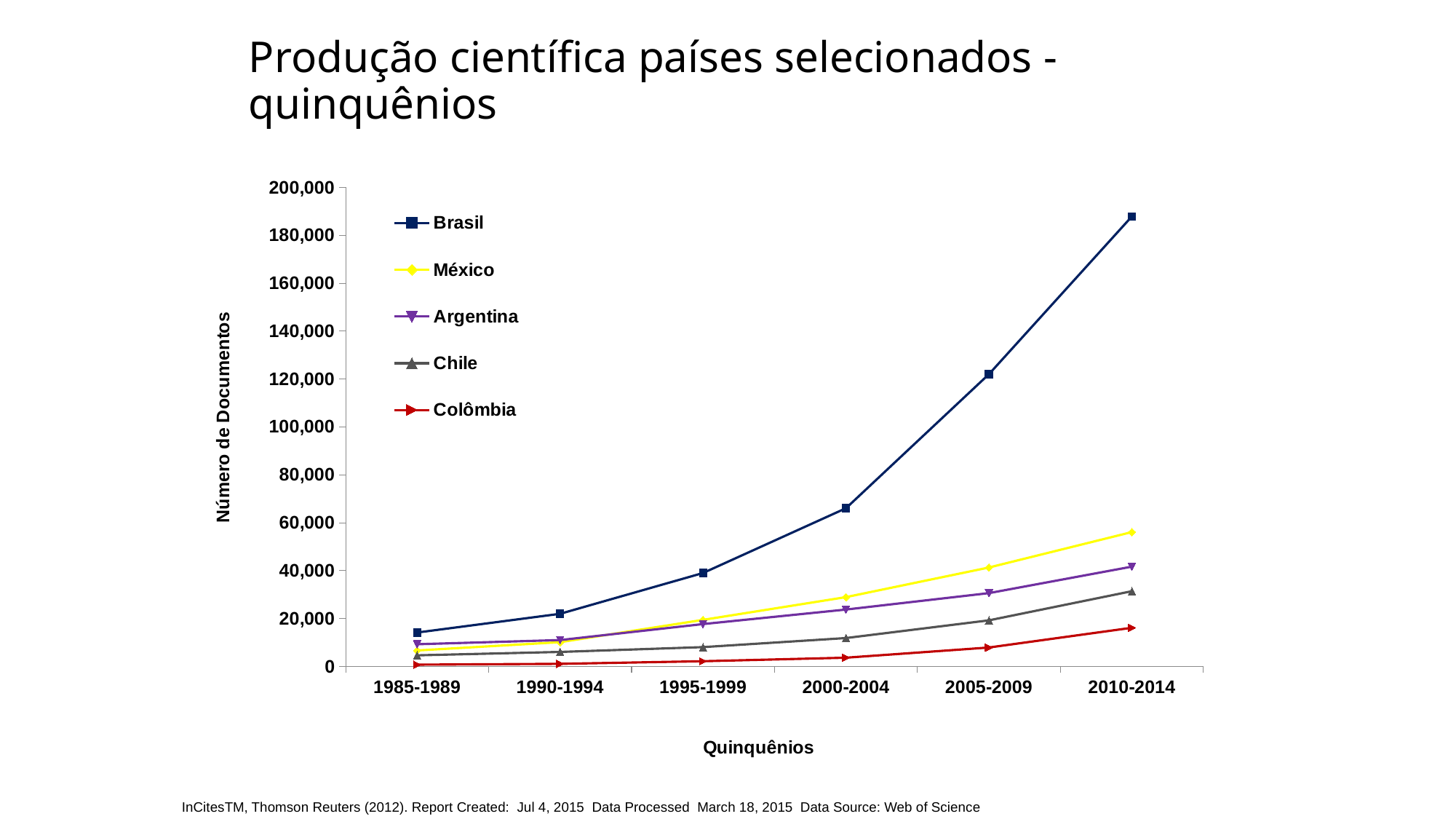
Does the Brasil line rise or fall from 1985-1989 to 2010-2014? rises Is the value for Brasil in 2005-2009 greater or less than 100,000? greater What is the title of the y axis? Número de Documentos Which country has the highest number of documents in 2010-2014? Brasil Is the value for Brasil in 2010-2014 greater or less than 180,000? greater Which is larger in 2010-2014, the value for Argentina or the value for Chile? Argentina How many quinquênios (periods) are shown on the x axis? 6 Which is larger in 2005-2009, the value for México or the value for Argentina? México Which country has the lowest number of documents in 2010-2014? Colômbia What kind of chart is shown on the slide? line chart How many series does the legend list? 5 Is the value for Colômbia in 2010-2014 greater or less than 20,000? less